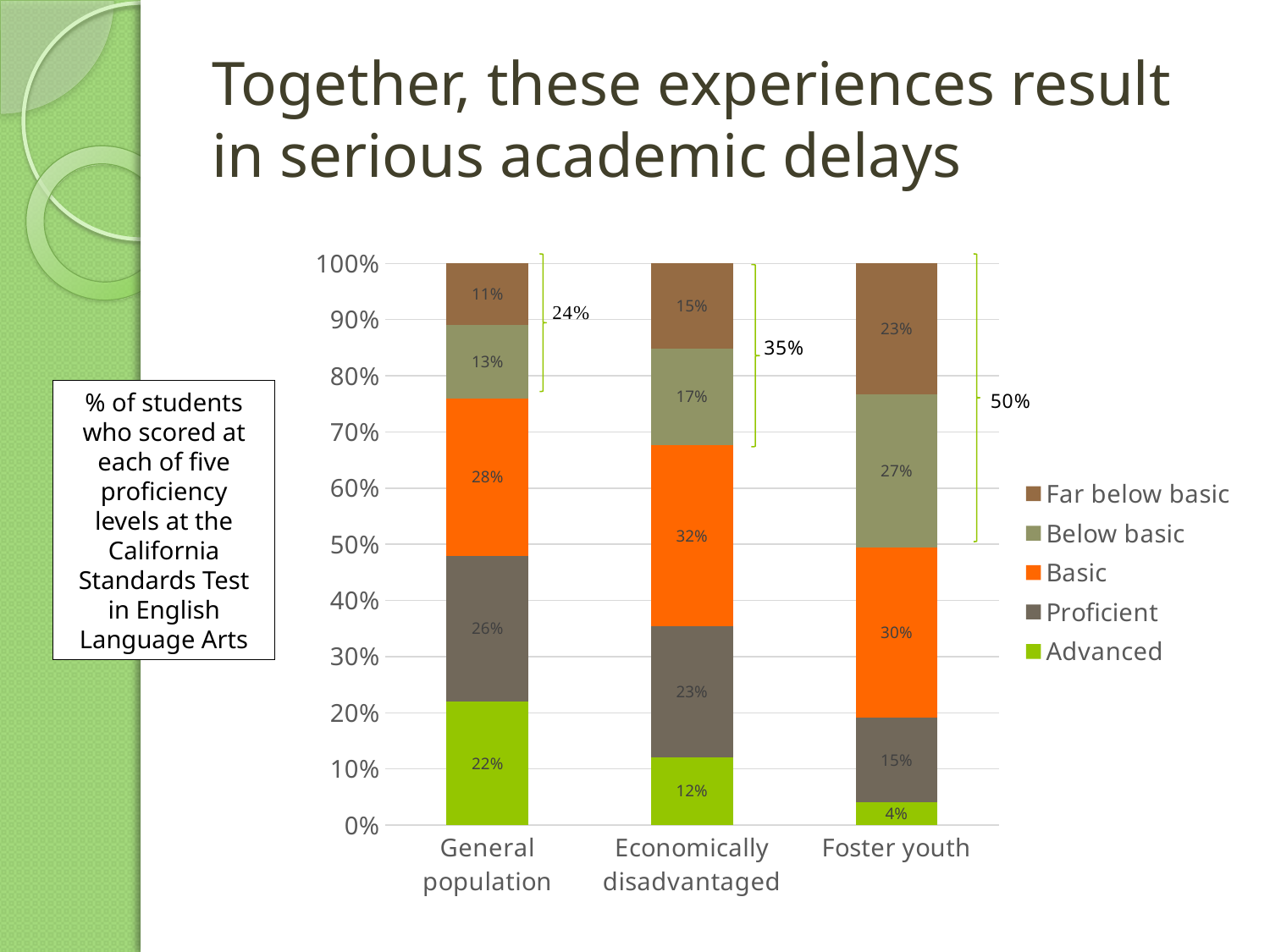
Which group has the lowest percentage of students scoring Proficient? Foster youth What is the difference between the Advanced percentage for the general population and for foster youth? 18% How many student groups are shown on the x axis? 3 Which is larger: the Basic percentage for economically disadvantaged students or for foster youth? Economically disadvantaged What percentage of economically disadvantaged students scored Below basic? 17% Which legend entry is shown in orange? Basic What is the combined percentage of foster youth scoring Below basic or Far below basic, as annotated on the chart? 50% What kind of chart is shown on the slide? Stacked bar chart How many series does the legend list? 5 What percentage of foster youth scored Advanced? 4% Which group has the highest percentage of students scoring Far below basic? Foster youth What percentage of the general population scored Basic? 28%